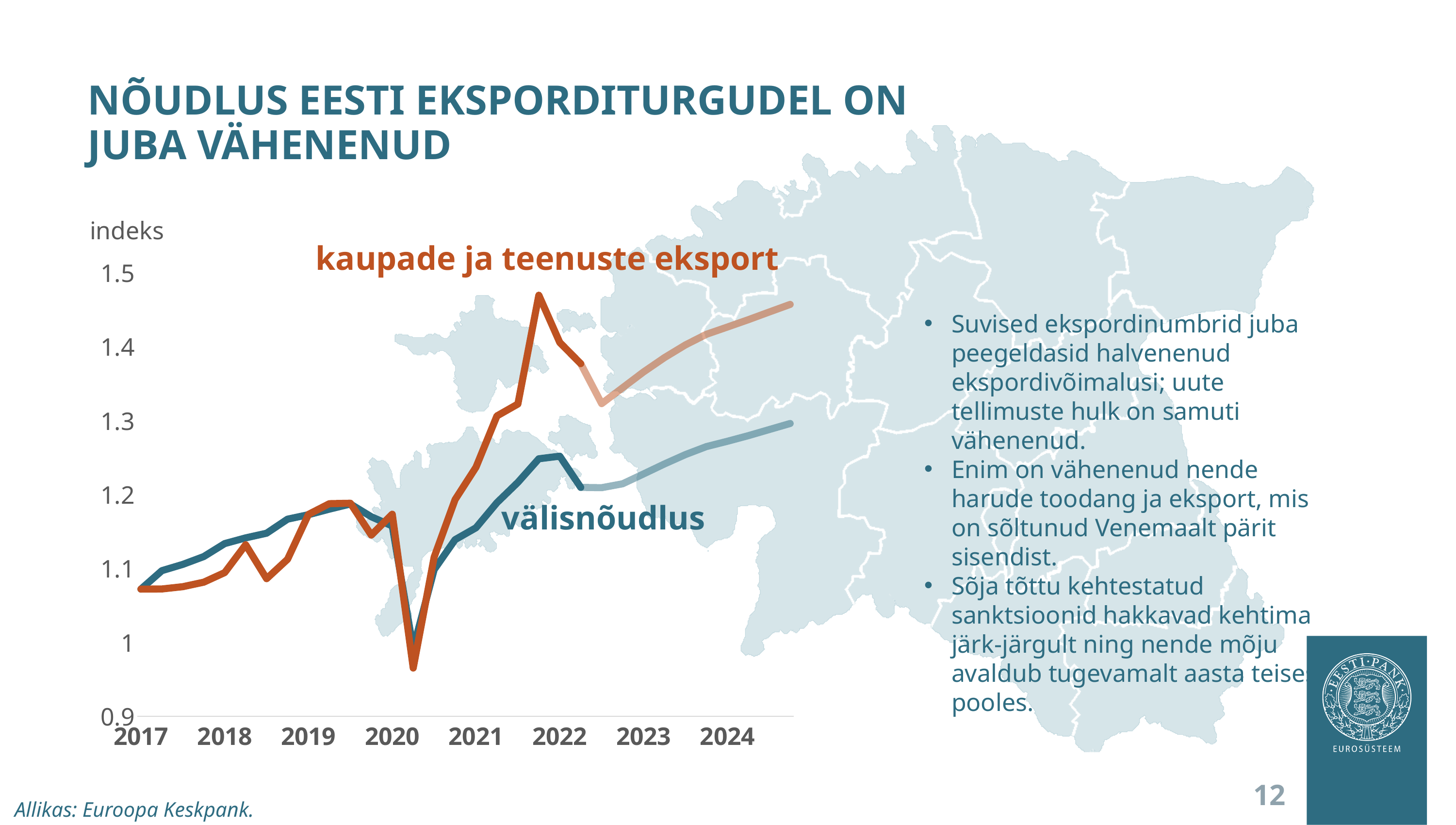
How many year labels are shown on the x axis? 8 How many series are plotted on the chart? 2 Is the peak value of the 'kaupade ja teenuste eksport' line in 2022 greater or less than 1.4? greater What are the names of the two series plotted on the chart? kaupade ja teenuste eksport; välisnõudlus Is the peak value of the 'välisnõudlus' line in 2022 greater or less than 1.3? less What label is shown on the vertical axis of the chart? indeks Does the 'kaupade ja teenuste eksport' line rise or fall overall from 2017 to its 2022 peak? rise What kind of chart is shown on the slide? line chart Which series has the higher value at its 2022 peak, 'kaupade ja teenuste eksport' or 'välisnõudlus'? kaupade ja teenuste eksport Does the 'välisnõudlus' line rise or fall from 2023 to 2024? rise Is the lowest value of the 'kaupade ja teenuste eksport' line in 2020 greater or less than 1? less